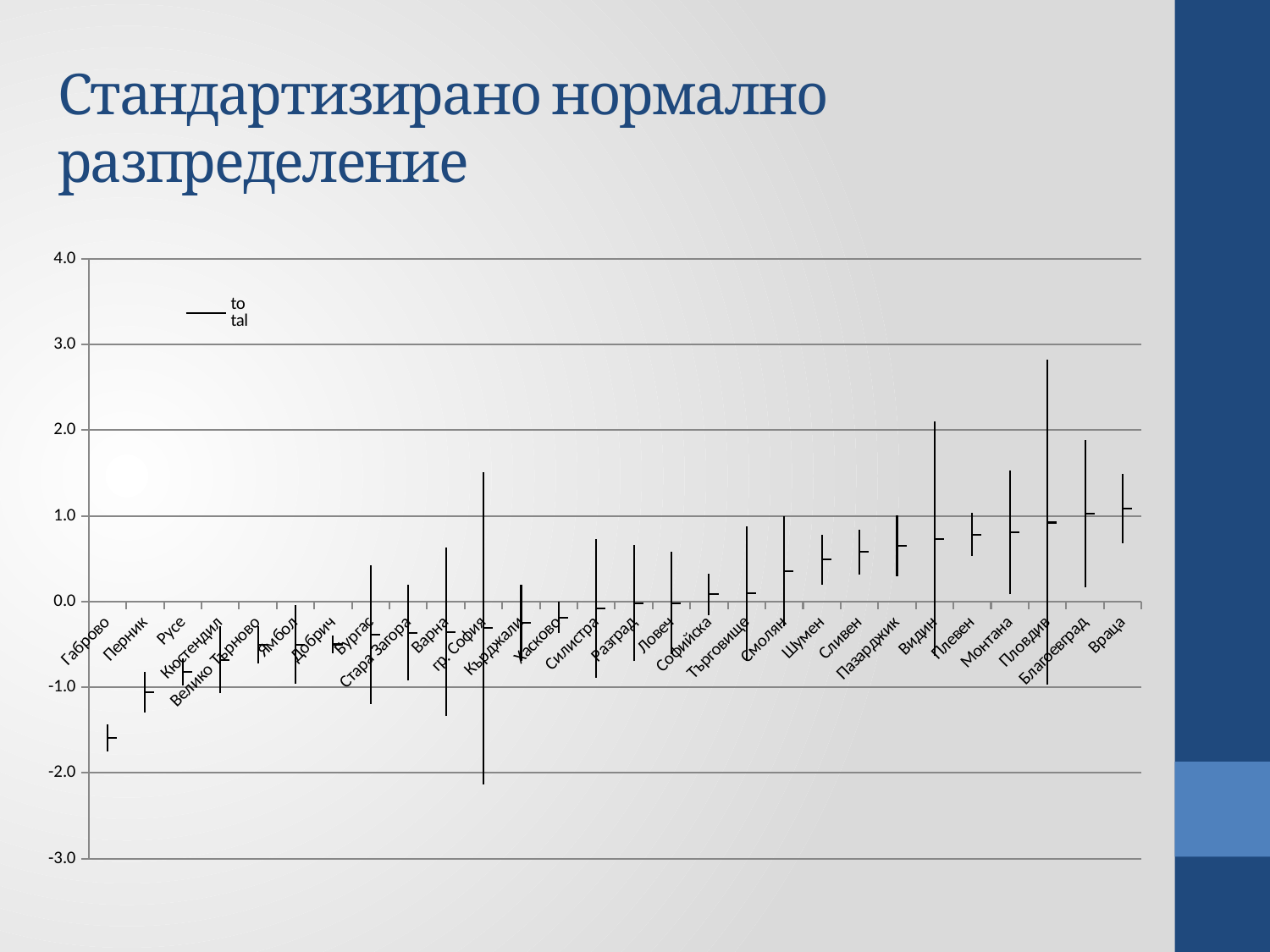
What series name does the chart legend show? total Is the value marker for Габрово greater or less than -1.0? less Is the value marker for Шумен greater or less than 1.0? less Do the value markers generally rise or fall moving from left to right along the x axis? rise How many categories (regions) are shown along the x axis? 28 Is the value marker for Кърджали greater or less than 0.0? less How many series does the legend list? 1 What is the title of the chart on the slide? Стандартизирано нормално разпределение Which has the larger value marker, Габрово or Враца? Враца Which region has the lowest value marker on the chart? Габрово